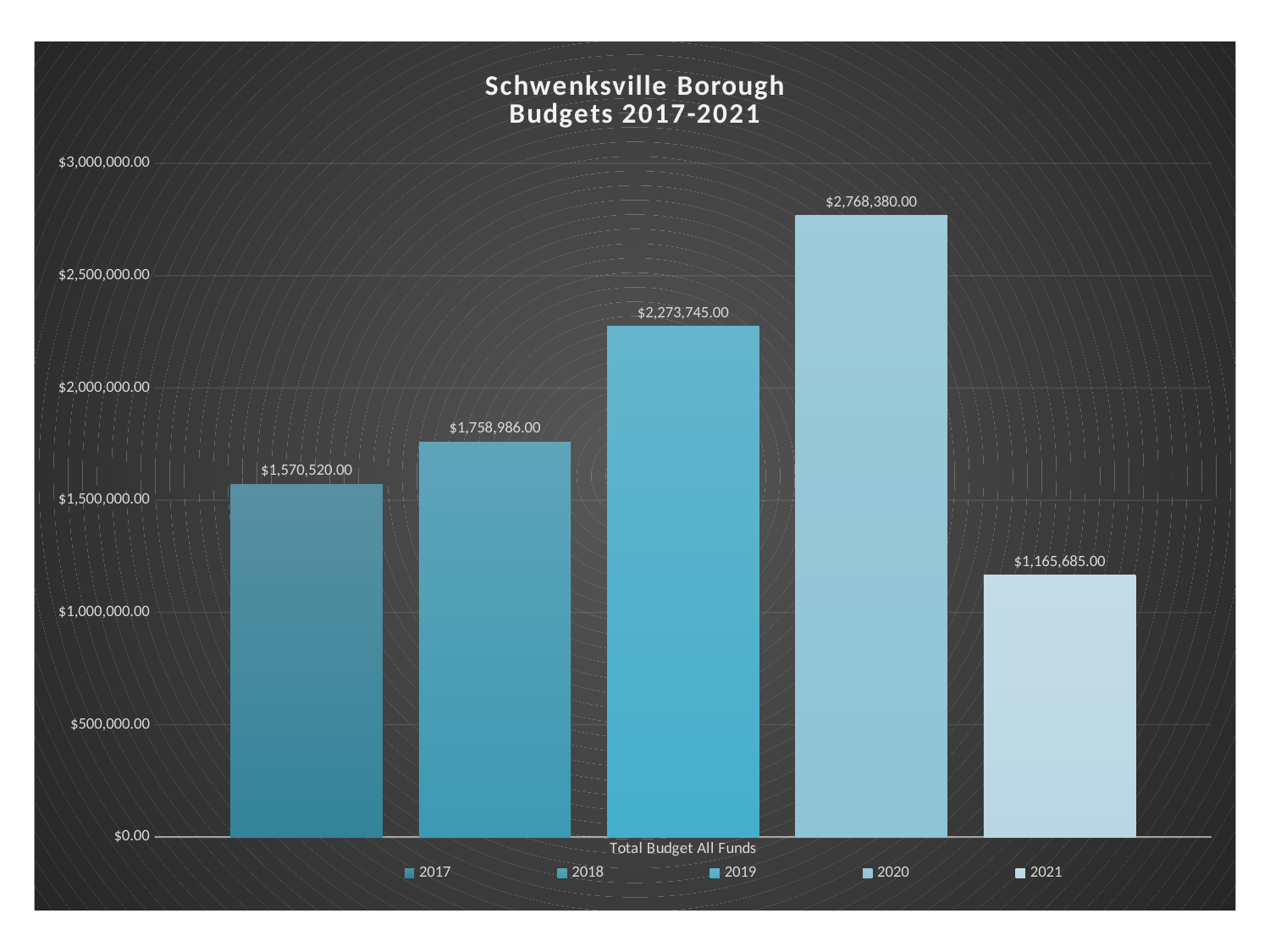
What is the difference between the 2018 budget and the 2017 budget? $188,466.00 What is the difference between the 2020 budget and the 2019 budget? $494,635.00 What is the budget value shown for 2017? $1,570,520.00 Do the budget values rise or fall from 2017 through 2020? Rise Which is larger, the budget for 2018 or the budget for 2021? 2018 What kind of chart is shown on the slide? Bar chart How many series does the legend list? 5 What is the budget value shown for 2019? $2,273,745.00 Which year has the lowest budget? 2021 What is the budget value shown for 2021? $1,165,685.00 Is the value for 2020 greater or less than $2,500,000.00? greater Which year has the highest budget? 2020